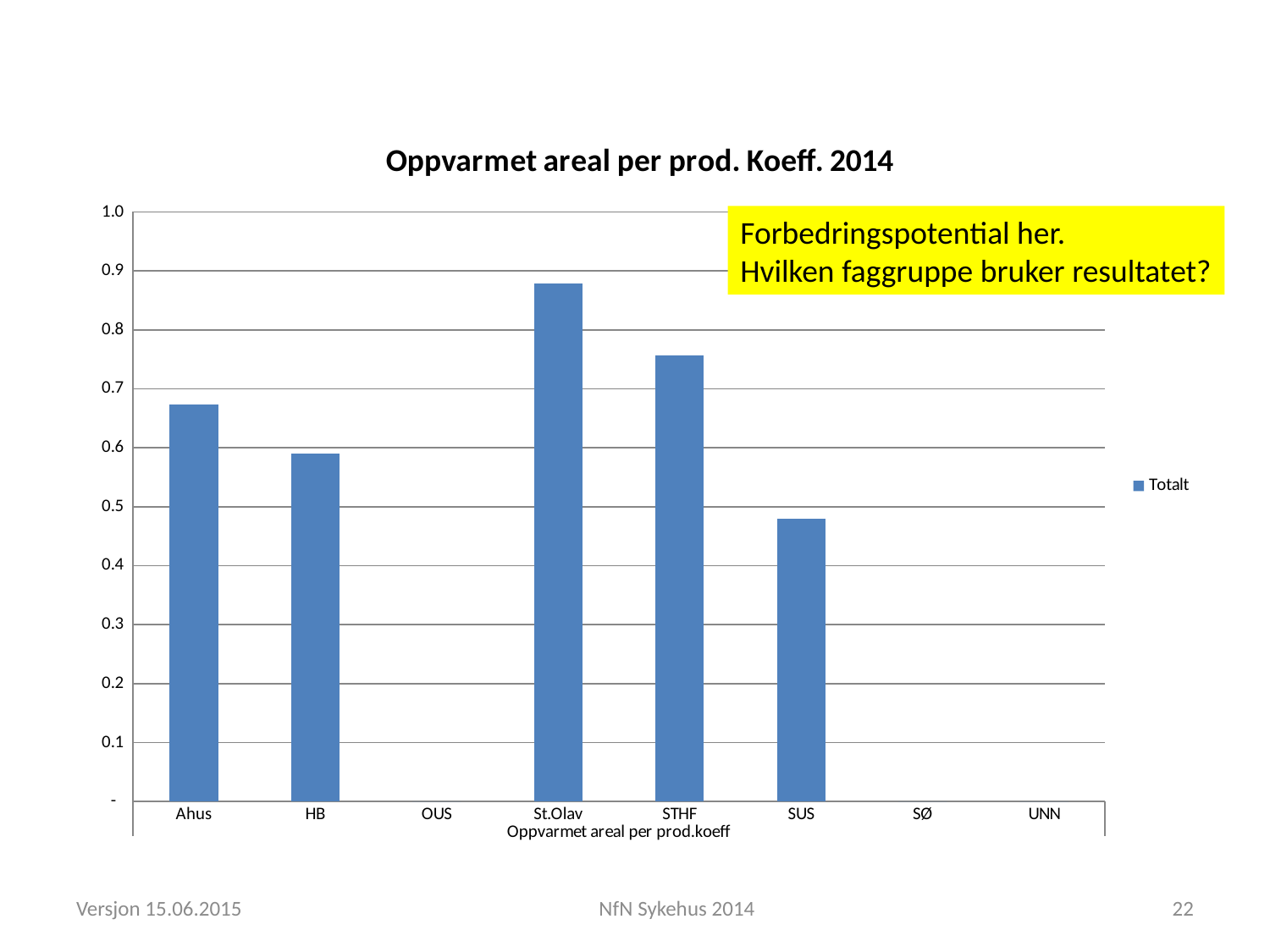
Is the value for St.Olav greater or less than 0.8? greater How many categories are shown on the x axis of the chart? 8 Which category has the highest bar? St.Olav Is the value for STHF greater or less than 0.8? less Which is larger, the value for Ahus or the value for HB? Ahus Which is larger, the value for STHF or the value for SUS? STHF How many series does the legend list? 1 Is the value for Ahus greater or less than 0.6? greater What is the title of the chart? Oppvarmet areal per prod. Koeff. 2014 What is the name of the series in the legend? Totalt What kind of chart is shown on the slide? bar chart Which category has the lowest bar among those with a visible bar? SUS